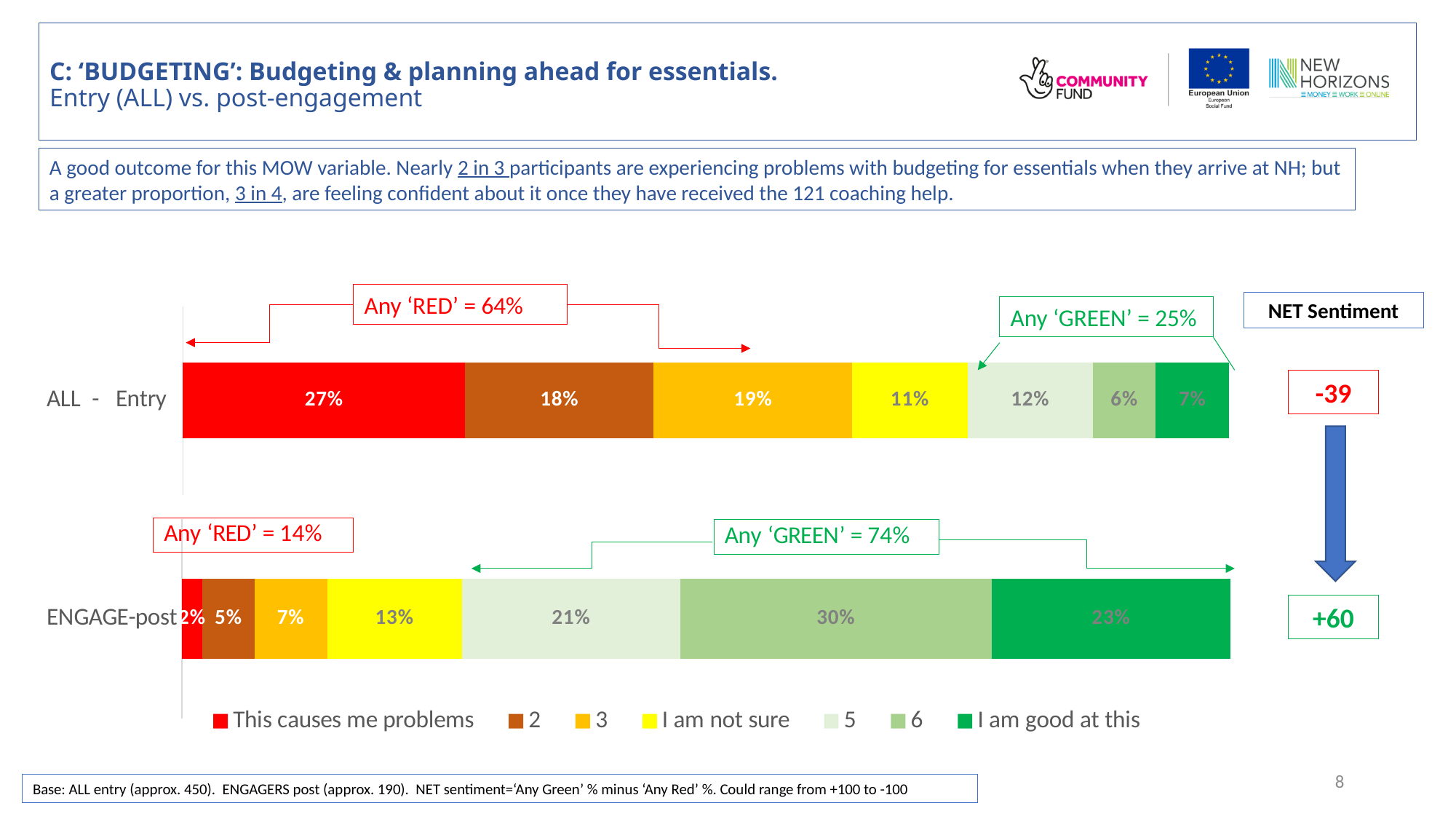
How many bars (categories) are shown in the chart? 2 How many series does the legend list? 7 What percentage of the 'ENGAGE-post' bar is 'I am good at this'? 23% What is the value for 'I am not sure' in the 'ENGAGE-post' bar? 13% What is the NET Sentiment value shown for 'ENGAGE-post'? +60 What is the difference between the 'This causes me problems' values for 'ALL - Entry' and 'ENGAGE-post'? 25% What is the value for series '6' in the 'ALL - Entry' bar? 6% Which series has the largest segment in the 'ENGAGE-post' bar? 6 What percentage of the 'ALL - Entry' bar is 'This causes me problems'? 27% Which series has the smallest segment in the 'ENGAGE-post' bar? This causes me problems What kind of chart is shown on the slide? Stacked bar chart Which bar has the larger value for series '5': 'ALL - Entry' or 'ENGAGE-post'? ENGAGE-post